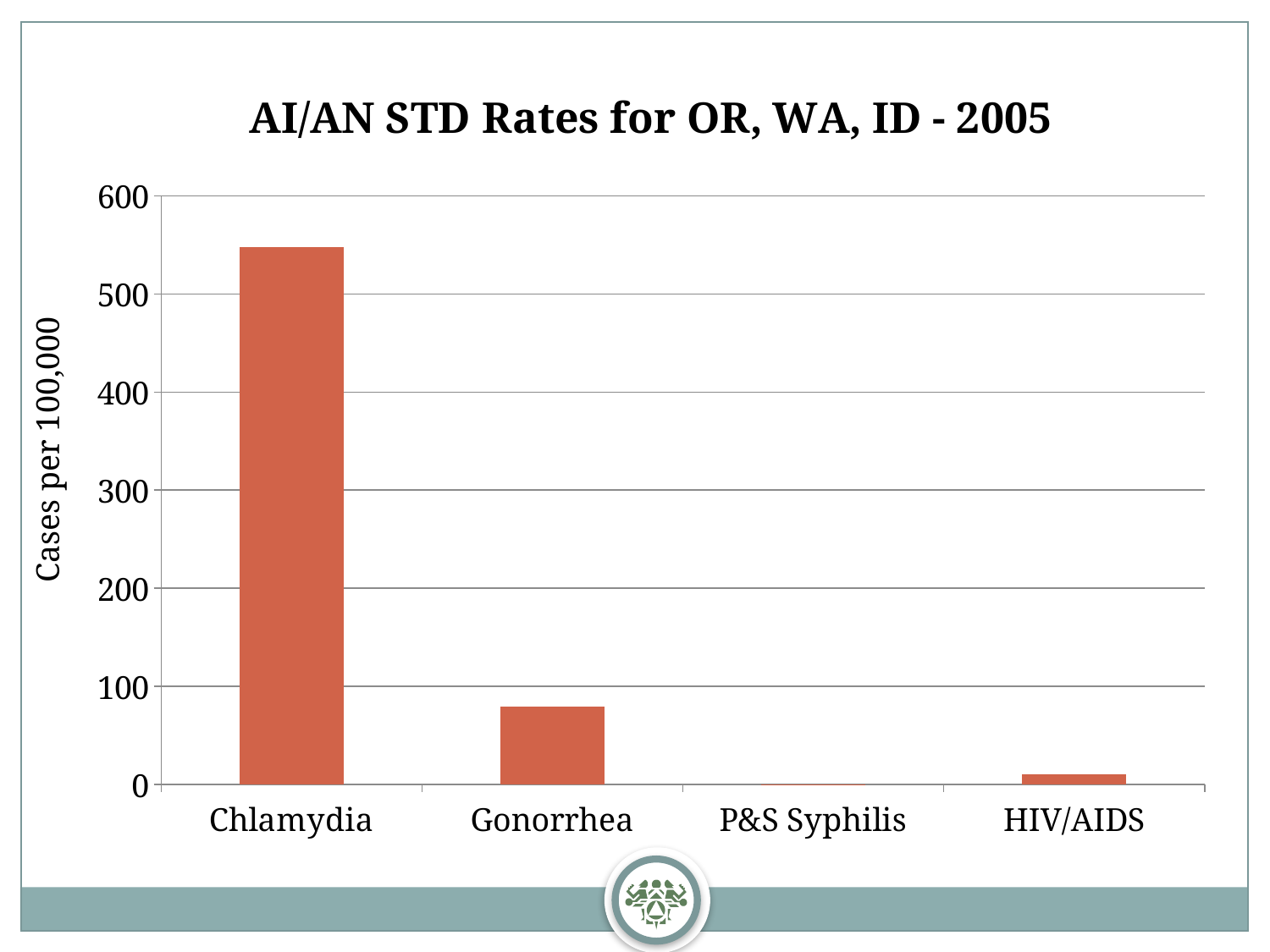
What is the label of the vertical axis? Cases per 100,000 What type of chart is shown on the slide? bar chart What is the highest tick value shown on the vertical axis? 600 Which category has the lowest rate? P&S Syphilis How many categories are shown on the x axis? 4 Is the value for Gonorrhea greater or less than 100? less Is the value for HIV/AIDS greater or less than 100? less Which is larger, the value for Gonorrhea or the value for HIV/AIDS? Gonorrhea What is the title of the chart? AI/AN STD Rates for OR, WA, ID - 2005 Is the value for Chlamydia greater or less than 500? greater Which is larger, the value for Chlamydia or the value for Gonorrhea? Chlamydia Which category has the highest rate? Chlamydia